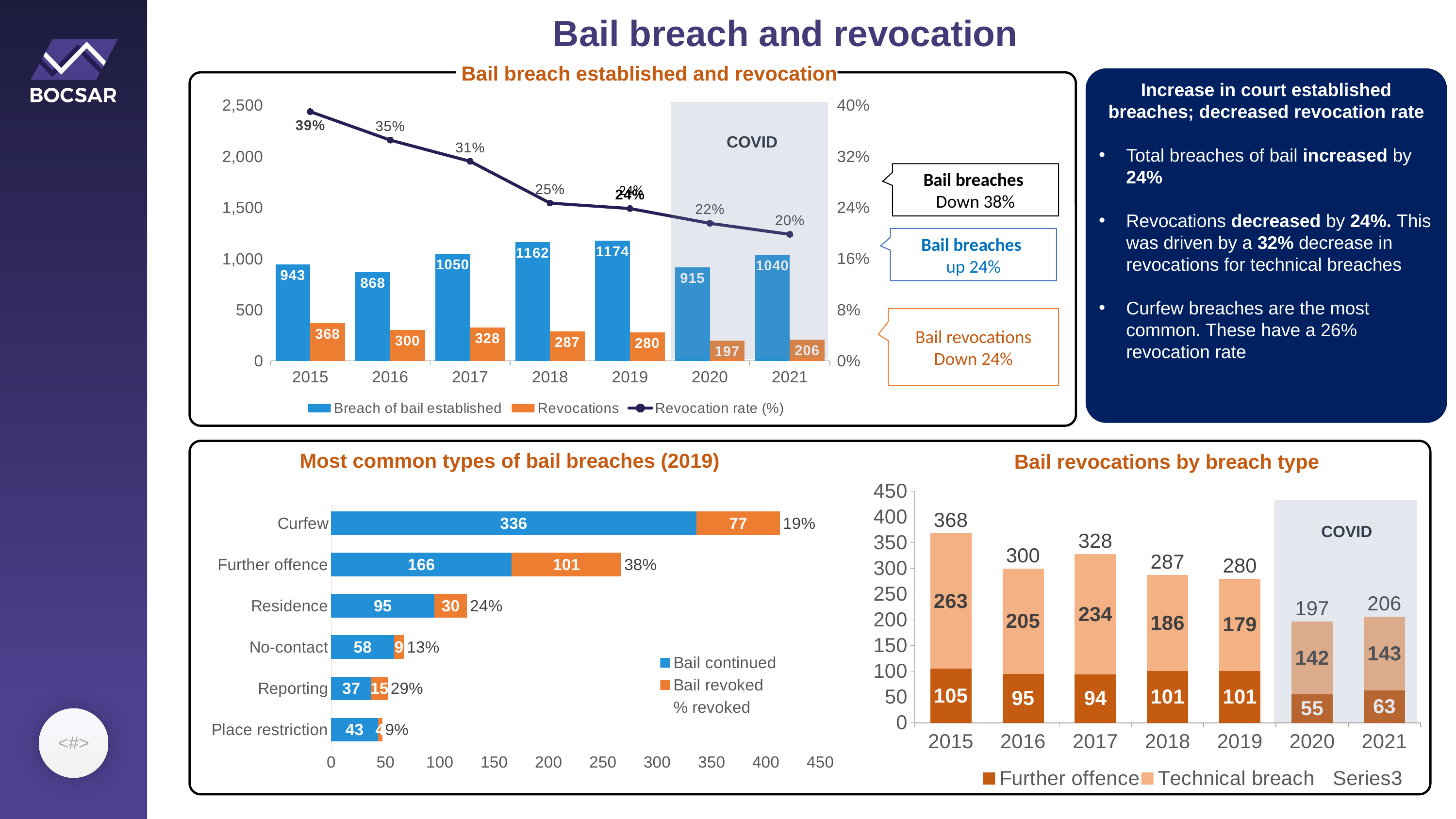
In the 'Bail revocations by breach type' chart, which is larger: Technical breach in 2018 or Technical breach in 2019? 2018 In the 'Bail breach established and revocation' chart, does the revocation rate rise or fall from 2015 to 2021? fall In the 'Most common types of bail breaches (2019)' chart, which breach type has the highest % revoked? Further offence In the 'Bail breach established and revocation' chart, what is the revocation rate for 2021? 20% In the 'Most common types of bail breaches (2019)' chart, what is the Bail revoked value for Further offence? 101 In the 'Bail breach established and revocation' chart, what is the value for Breach of bail established in 2019? 1174 In the 'Bail breach established and revocation' chart, what is the difference between Breach of bail established in 2018 and 2016? 294 How many series does the legend of the 'Bail breach established and revocation' chart list? 3 How many breach types are shown in the 'Most common types of bail breaches (2019)' chart? 6 In the 'Bail breach established and revocation' chart, which year has the lowest number of Revocations? 2020 In the 'Bail revocations by breach type' chart, what is the total of the stacked bar for 2017? 328 What kind of chart is 'Most common types of bail breaches (2019)'? bar chart